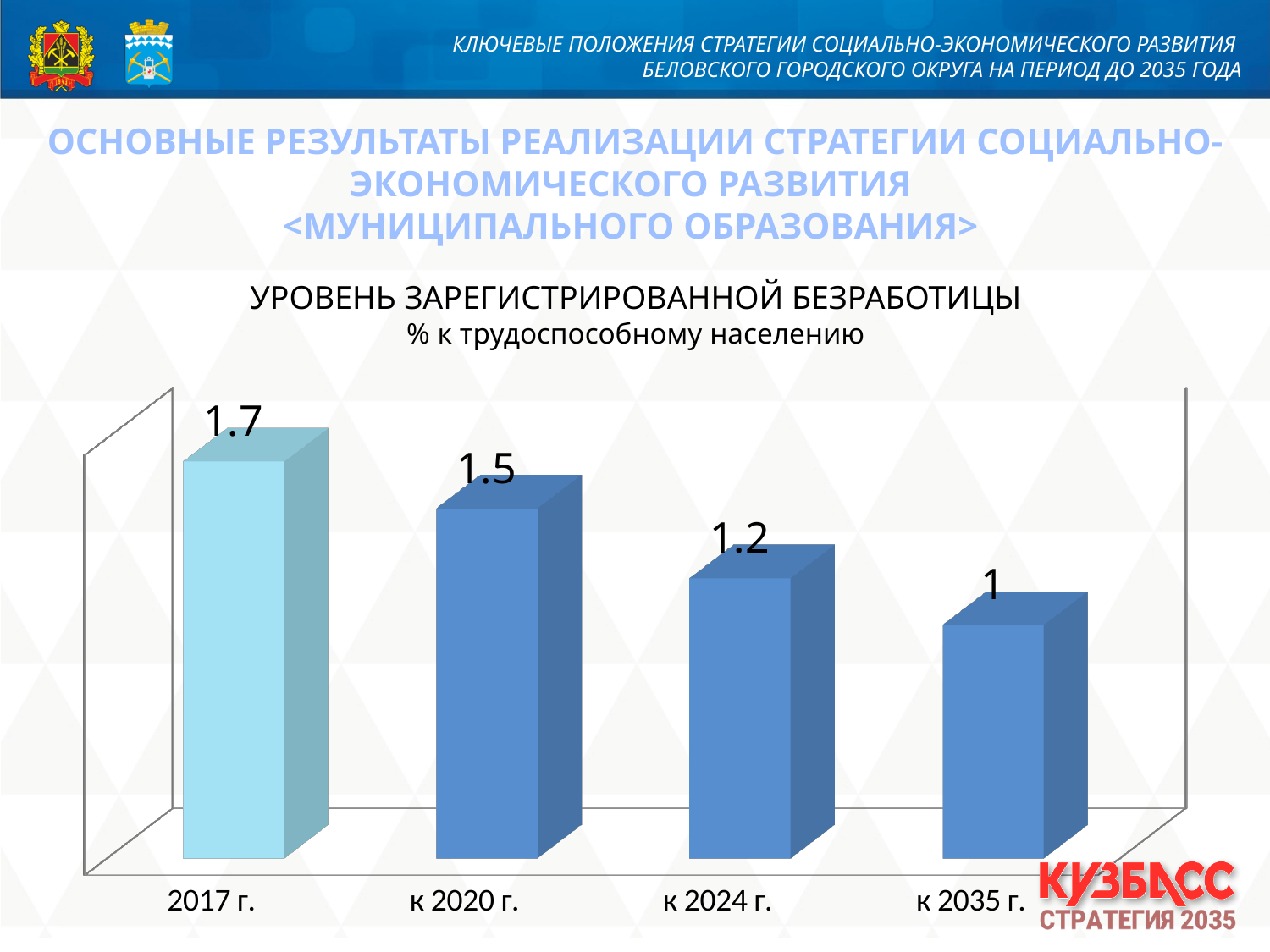
Which is larger, the value for к 2020 г. or the value for к 2024 г.? к 2020 г. Which category has the highest value? 2017 г. How many categories are shown on the chart? 4 What is the difference between the values for 2017 г. and к 2035 г.? 0.7 What value is shown for к 2024 г.? 1.2 What is the difference between the values for к 2020 г. and к 2024 г.? 0.3 Which category has the lowest value? к 2035 г. What value is shown for к 2020 г.? 1.5 Do the values rise or fall from 2017 г. to к 2035 г.? fall What is the registered unemployment rate shown for 2017 г.? 1.7 What value is shown for к 2035 г.? 1 What kind of chart is shown on the slide? bar chart